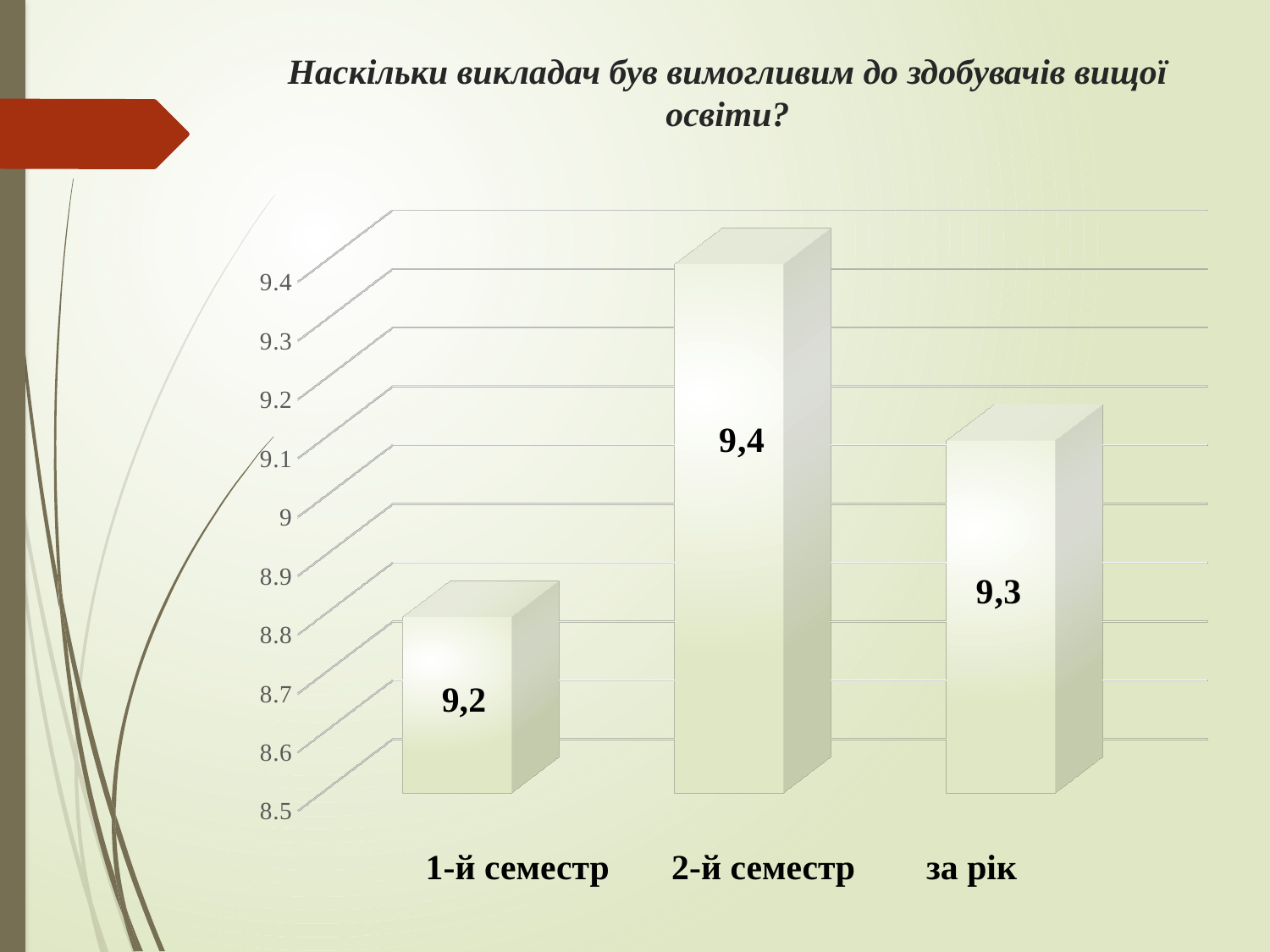
Which category has the highest value? 2-й семестр What is the value for 1-й семестр? 9,2 What is the lowest value shown on the vertical axis? 8.5 What is the title of the chart? Наскільки викладач був вимогливим до здобувачів вищої освіти? What kind of chart is shown on the slide? bar chart Which category has the lowest value? 1-й семестр What is the value for за рік? 9,3 What is the value for 2-й семестр? 9,4 What is the difference between the values for 2-й семестр and 1-й семестр? 0,2 How many categories are shown on the x axis? 3 Which is larger, the value for за рік or the value for 1-й семестр? за рік